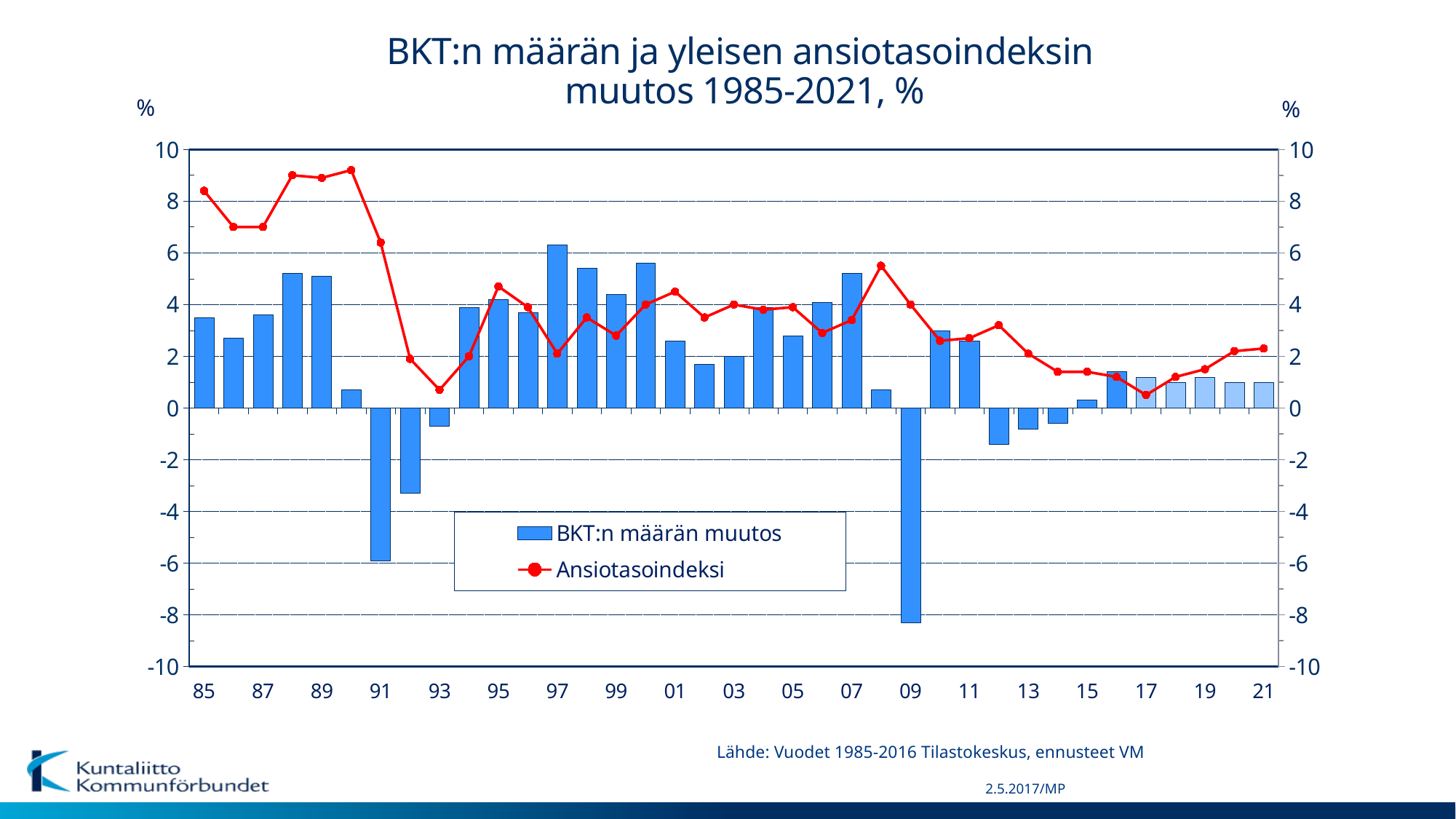
Is the BKT:n määrän muutos bar for 09 greater or less than -6? less Which year has the lowest bar for BKT:n määrän muutos? 09 Is the Ansiotasoindeksi value for 93 greater or less than 2? less Does the Ansiotasoindeksi line rise or fall overall from 85 to 93? fall How many years (bars) are plotted on the x axis from 85 to 21? 37 What colour is the Ansiotasoindeksi line? Red How many series does the legend list? 2 Is the Ansiotasoindeksi value for 85 greater or less than 8? greater What kind of chart is shown on the slide? A combination bar and line chart Which is larger, the BKT:n määrän muutos bar for 97 or for 85? 97 Which year has the highest bar for BKT:n määrän muutos? 97